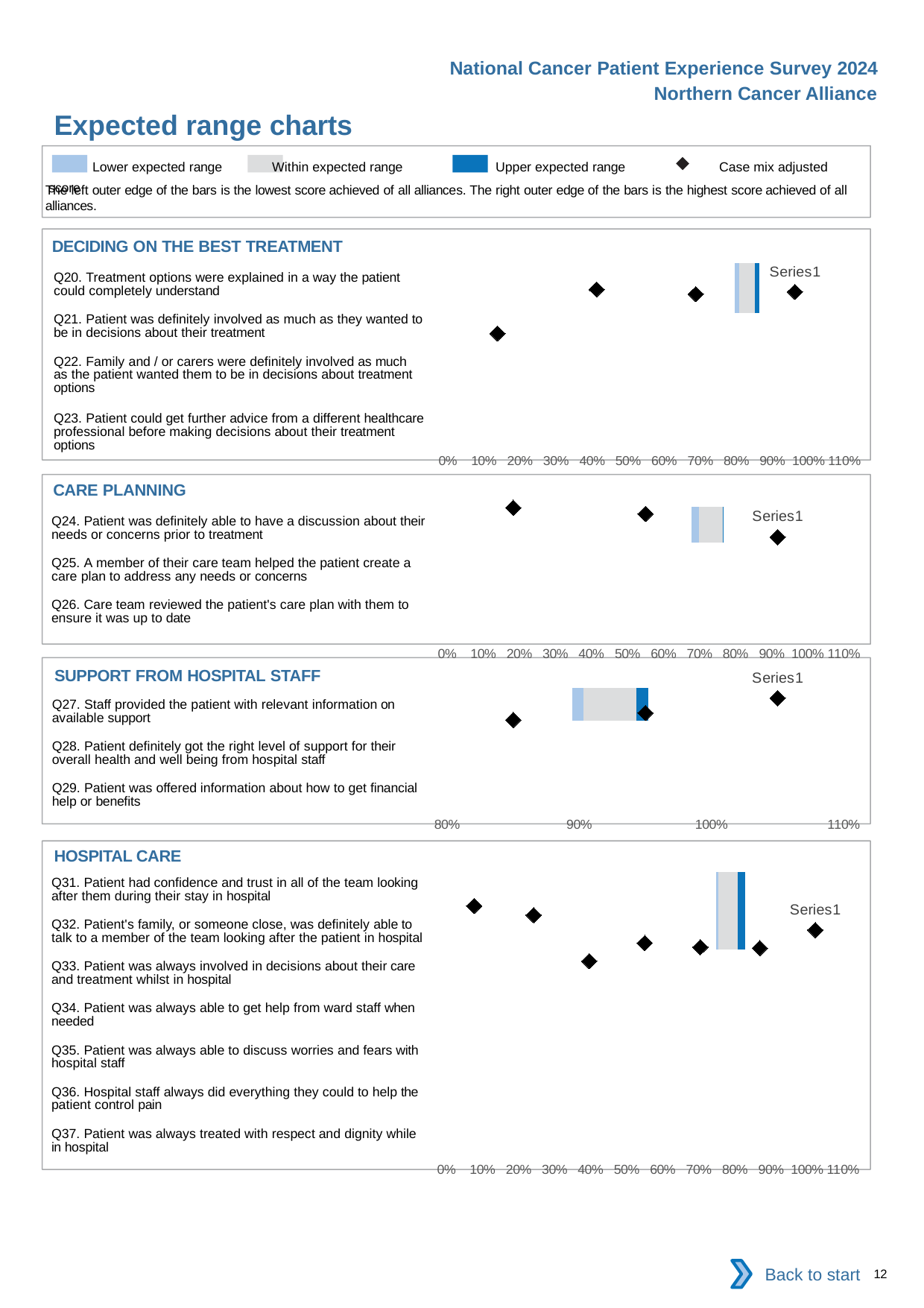
How many series does the legend of the 'HOSPITAL CARE' chart list? 1 How many questions are listed in the 'HOSPITAL CARE' chart? 7 What is the name of the series shown in the legend of the 'CARE PLANNING' chart? Series1 How many questions are listed in the 'DECIDING ON THE BEST TREATMENT' chart? 4 What is the lowest value shown on the x axis of the 'SUPPORT FROM HOSPITAL STAFF' chart? 80% How many questions are listed in the 'CARE PLANNING' chart? 3 What is the highest value shown on the x axis of the 'DECIDING ON THE BEST TREATMENT' chart? 110%